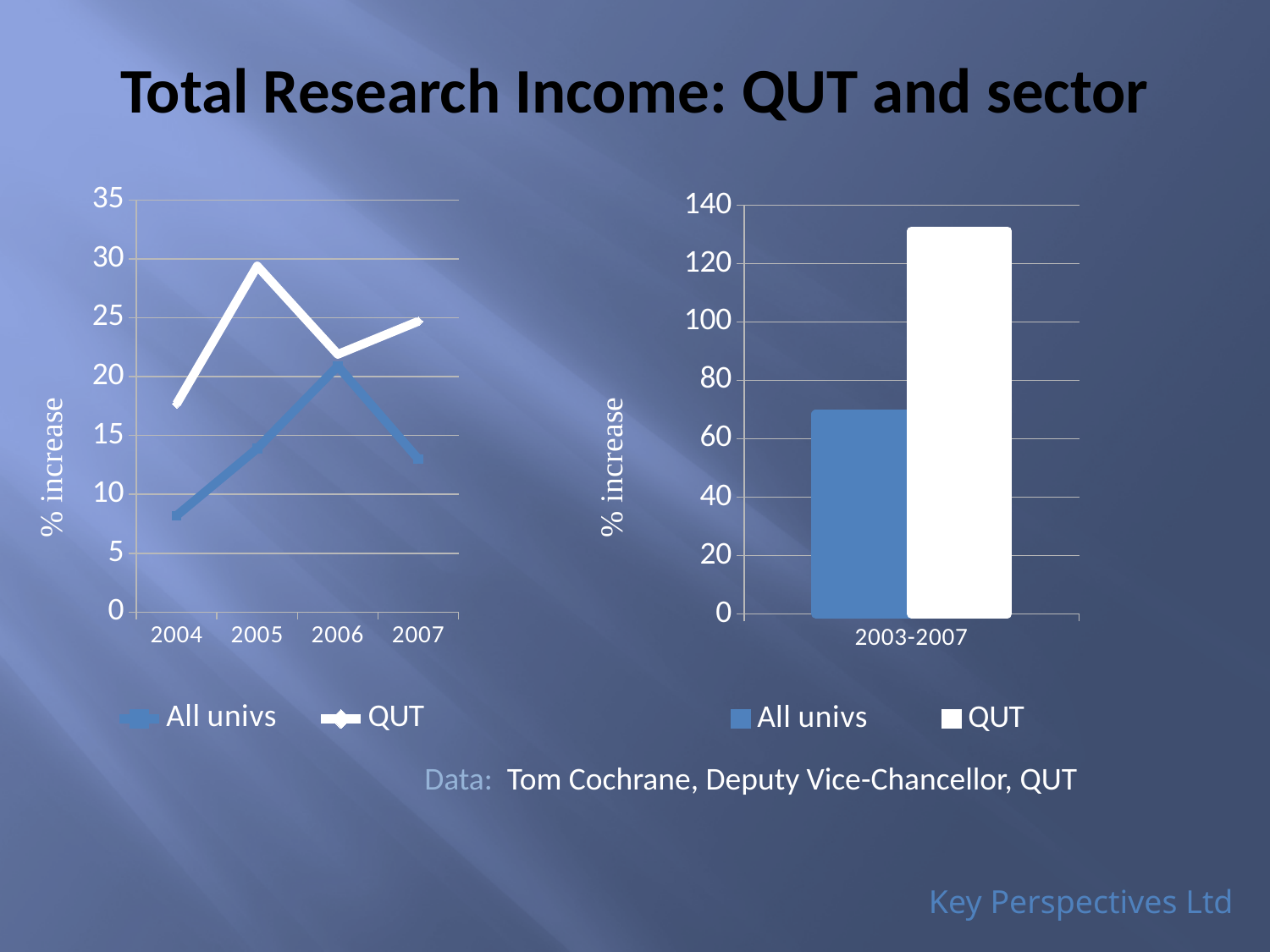
In the right chart, is the QUT value greater or less than 120? greater In the left chart, in which year is the All univs value lowest? 2004 In the right chart, which bar is taller, All univs or QUT? QUT In the left chart, how many series does the legend list? 2 What kind of chart is the chart on the left of the slide? line chart What kind of chart is the chart on the right of the slide? bar chart In the left chart, in which year is the QUT value highest? 2005 In the left chart, is the QUT value for 2005 greater or less than 25? greater In the left chart, which series has the larger value in 2007, All univs or QUT? QUT In the left chart, how many years are shown on the x axis? 4 In the left chart, is the All univs value for 2004 greater or less than 10? less